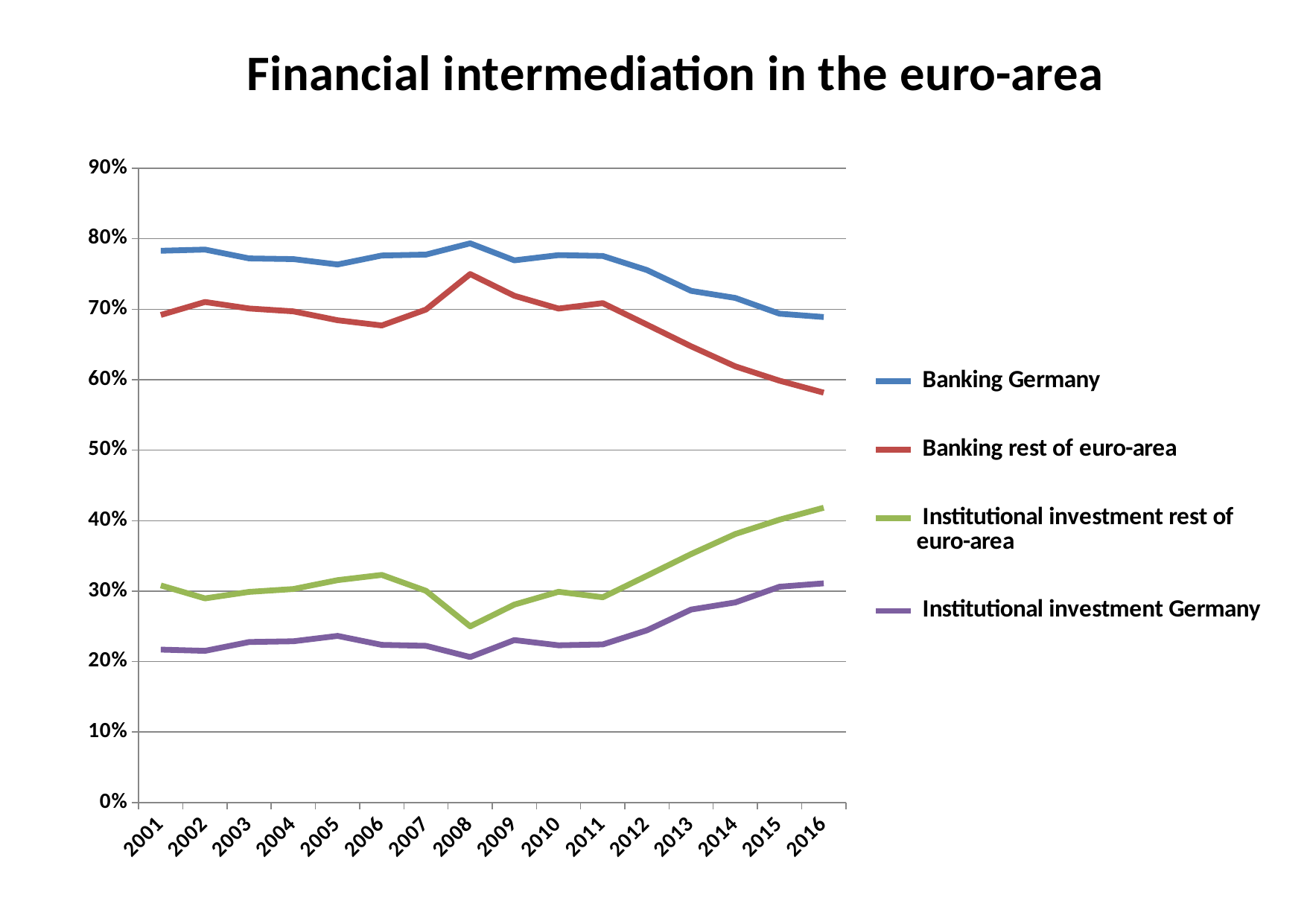
Is the value for Institutional investment Germany in 2008 greater or less than 30%? less How many series does the legend list? 4 Does the Banking rest of euro-area line rise or fall from 2011 to 2016? fall What kind of chart is shown on the slide? line chart In 2016, which is larger: Institutional investment rest of euro-area or Institutional investment Germany? Institutional investment rest of euro-area Is the value for Banking Germany in 2001 greater or less than 70%? greater In 2016, which is larger: Banking Germany or Banking rest of euro-area? Banking Germany How many years are shown on the x axis? 16 Is the value for Banking rest of euro-area in 2016 greater or less than 60%? less Which series has the highest values across the whole period? Banking Germany Does the Institutional investment rest of euro-area line rise or fall from 2011 to 2016? rise